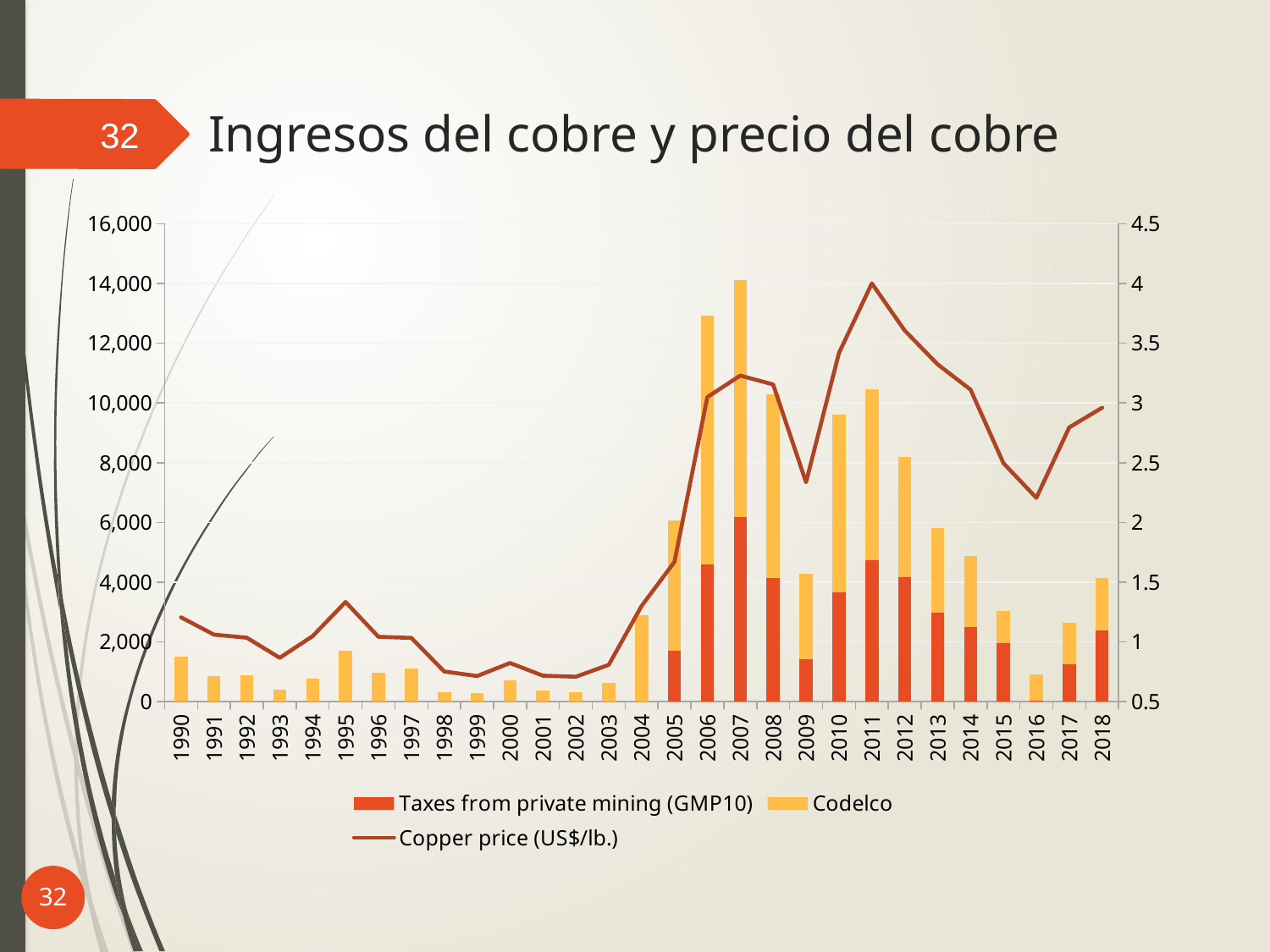
Is the total stacked bar for 2007 greater or less than 12,000? greater What kind of chart is shown on the slide? A combination of a stacked bar chart and a line chart In which year does the copper price line reach its highest point? 2011 How many series does the legend list? 3 What is the title of the slide containing the chart? Ingresos del cobre y precio del cobre Which year has the tallest stacked bar (Taxes from private mining plus Codelco)? 2007 Is the total stacked bar for 2004 greater or less than 4,000? less How many years are shown on the x axis of the chart? 29 Which is larger, the total stacked bar for 2007 or for 2010? 2007 Is the copper price in 2011 greater or less than 3.5 US$/lb.? greater Does the copper price line rise or fall from 2011 to 2016? fall